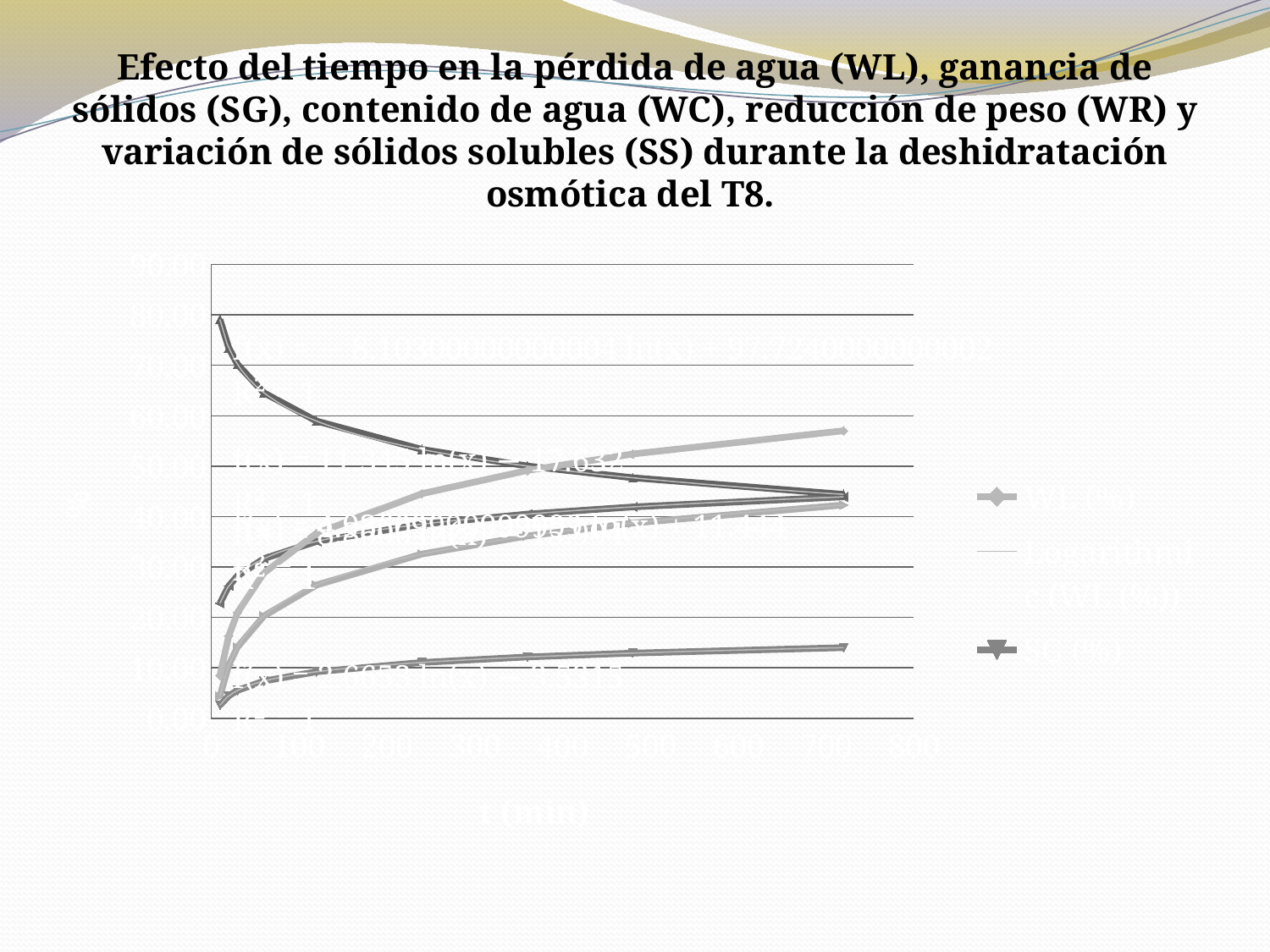
At the last time point, which series has the larger value, WL (%) or SG (%)? WL (%) Does the WL (%) series rise or fall as t (min) increases? rise Does the SG (%) series rise or fall as t (min) increases? rise What is the highest value shown on the y axis of the chart? 90.00 Is the value of SG (%) at the first time point (t = 0) greater or less than 10? less What is the title of the x axis of the chart? t (min) Is the value of SG (%) at the last time point (around 700 min) greater or less than 20? less Is the value of WL (%) at the last time point (around 700 min) greater or less than 50? greater What kind of chart is shown on the slide? line chart